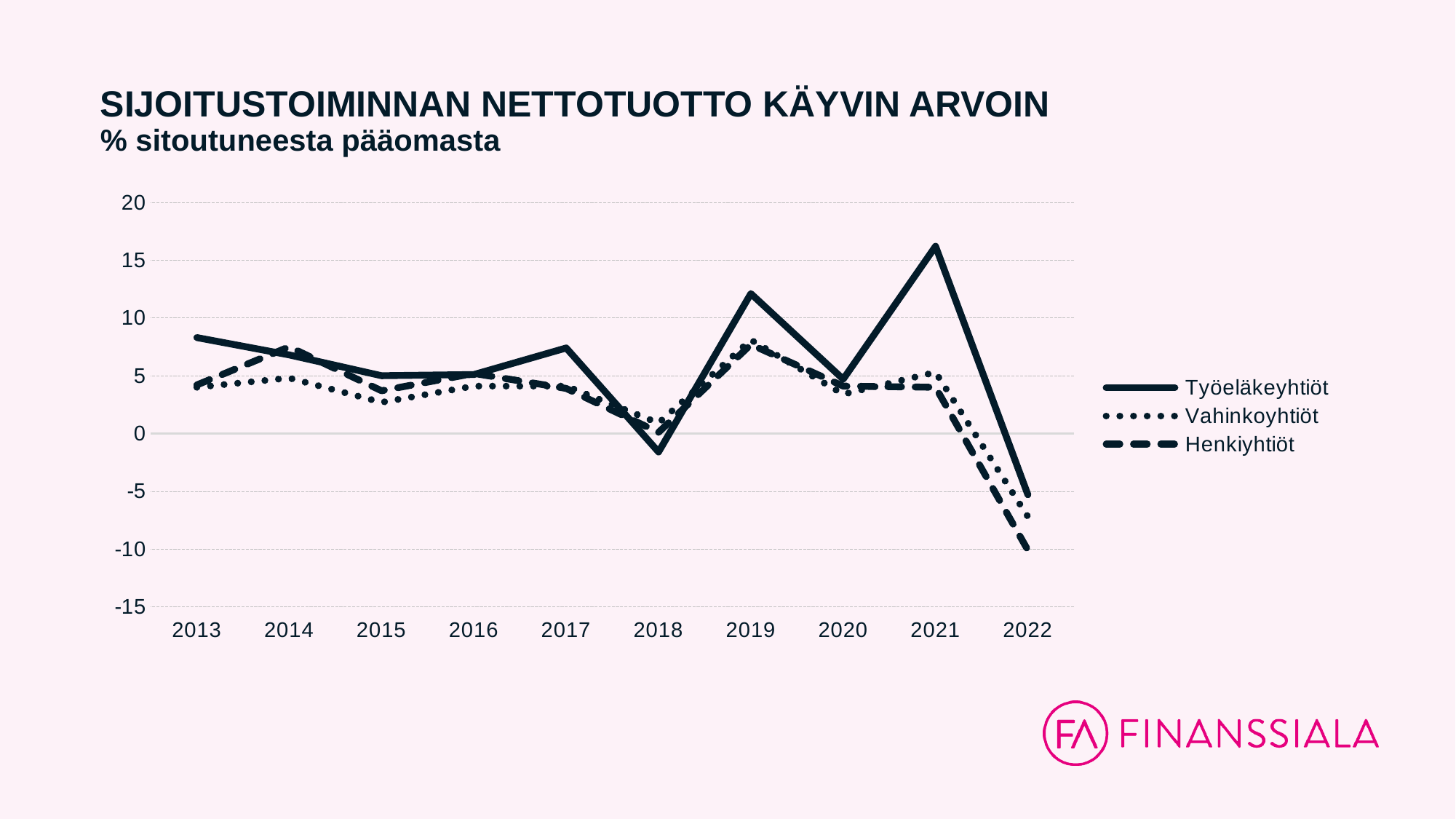
Is the value for Henkiyhtiöt in 2022 greater or less than -5? less In which year does the Työeläkeyhtiöt series reach its highest value? 2021 In which year does the Henkiyhtiöt series reach its lowest value? 2022 How many years are plotted along the x axis? 10 How many series does the legend list? 3 What kind of chart is shown on the slide? line chart What is the subtitle shown under the chart title? % sitoutuneesta pääomasta In 2021, which series has the larger value, Työeläkeyhtiöt or Henkiyhtiöt? Työeläkeyhtiöt Is the value for Työeläkeyhtiöt in 2019 greater or less than 10? greater Do the values for Henkiyhtiöt rise or fall from 2019 to 2022? fall Is the value for Työeläkeyhtiöt in 2018 greater or less than 0? less